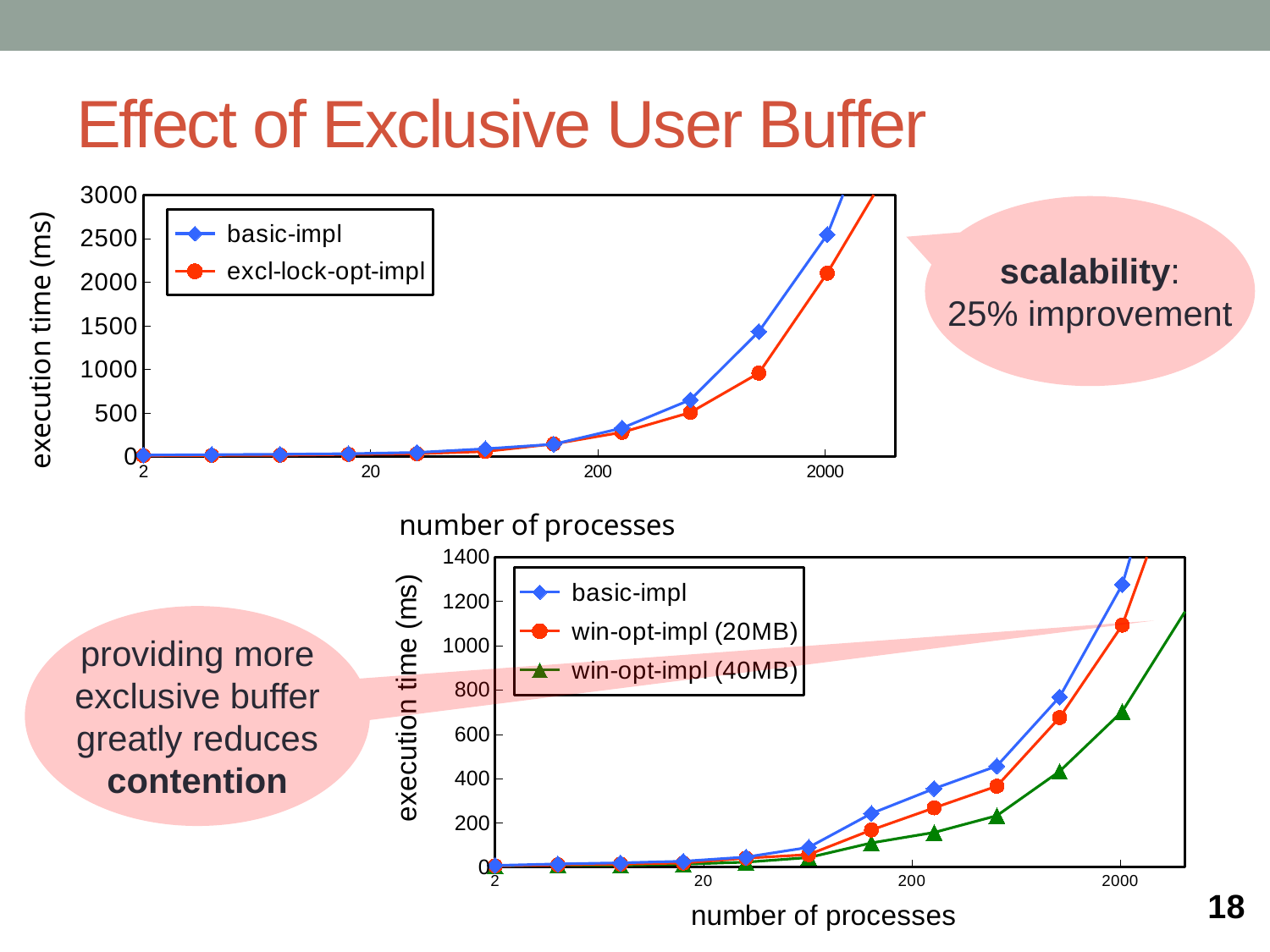
How many series does the legend of the bottom chart list? 3 In the top chart, is the value for basic-impl at 2000 processes greater or less than 2000? greater What kind of chart is the top chart on the slide? line chart How many series does the legend of the top chart list? 2 In the bottom chart, is the value for basic-impl at 2000 processes greater or less than 1200? greater In the top chart, is the value for excl-lock-opt-impl at 2000 processes greater or less than 2500? less In the top chart, which two series are listed in the legend? basic-impl and excl-lock-opt-impl In the bottom chart, at 2000 processes, which series has the larger value: basic-impl or win-opt-impl (40MB)? basic-impl In the bottom chart, what is the label of the y axis? execution time (ms) In the bottom chart, which series has the lowest execution time at 2000 processes? win-opt-impl (40MB) In the top chart, does execution time rise or fall as the number of processes increases? rise